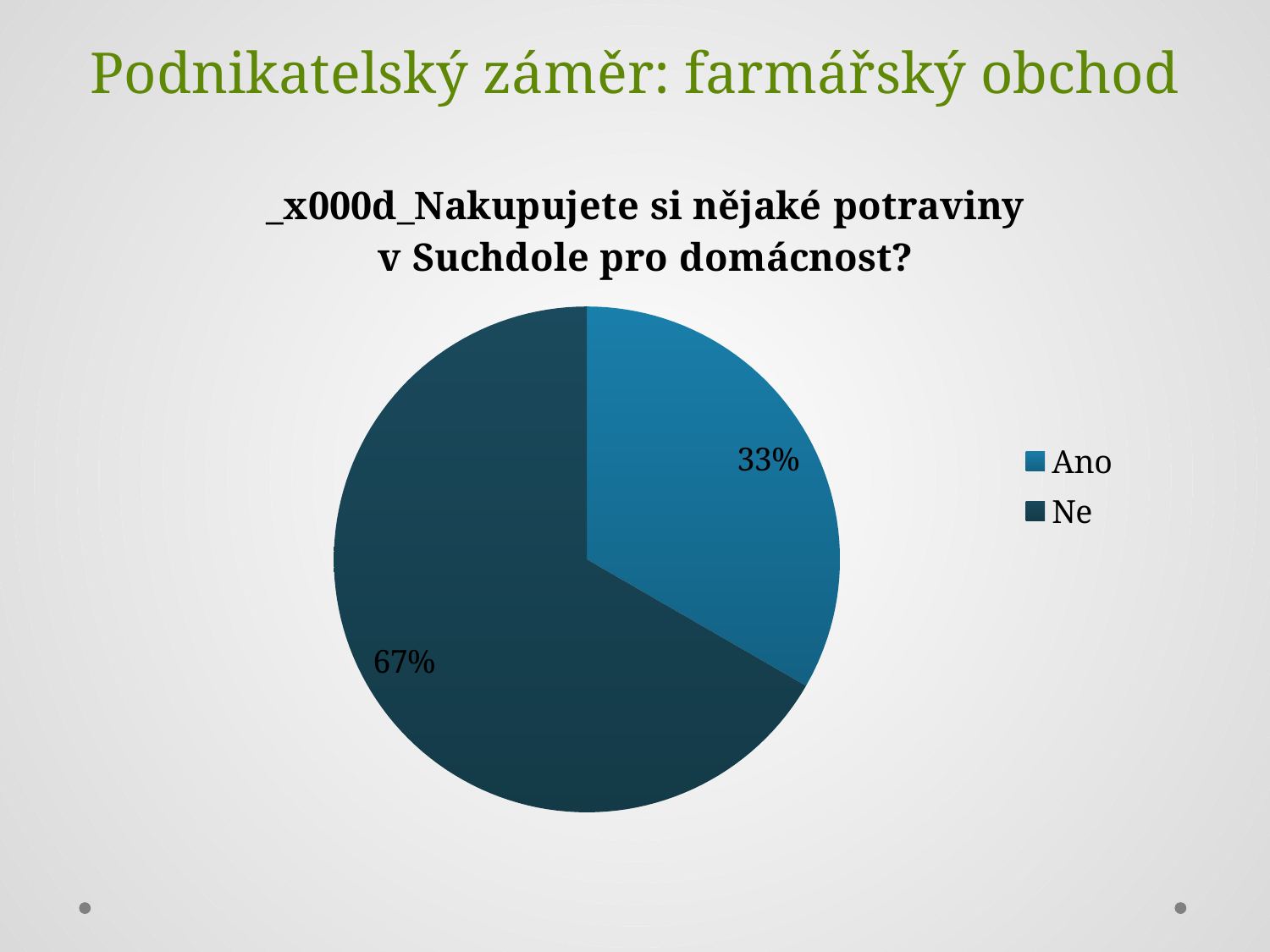
What is the title of the slide? Podnikatelský záměr: farmářský obchod Which slice is larger, "Ano" or "Ne"? Ne Which category has the smallest slice of the pie? Ano How many entries does the legend list? 2 How many slices does the pie chart have? 2 Which category has the largest slice of the pie? Ne Which legend entry is shown in the darker colour? Ne Is the share for "Ano" greater or less than 50%? less What share of the pie does the "Ano" slice represent? 33% What is the difference in percentage points between the "Ne" and "Ano" slices? 34 What kind of chart is shown on the slide? Pie chart What share of the pie does the "Ne" slice represent? 67%